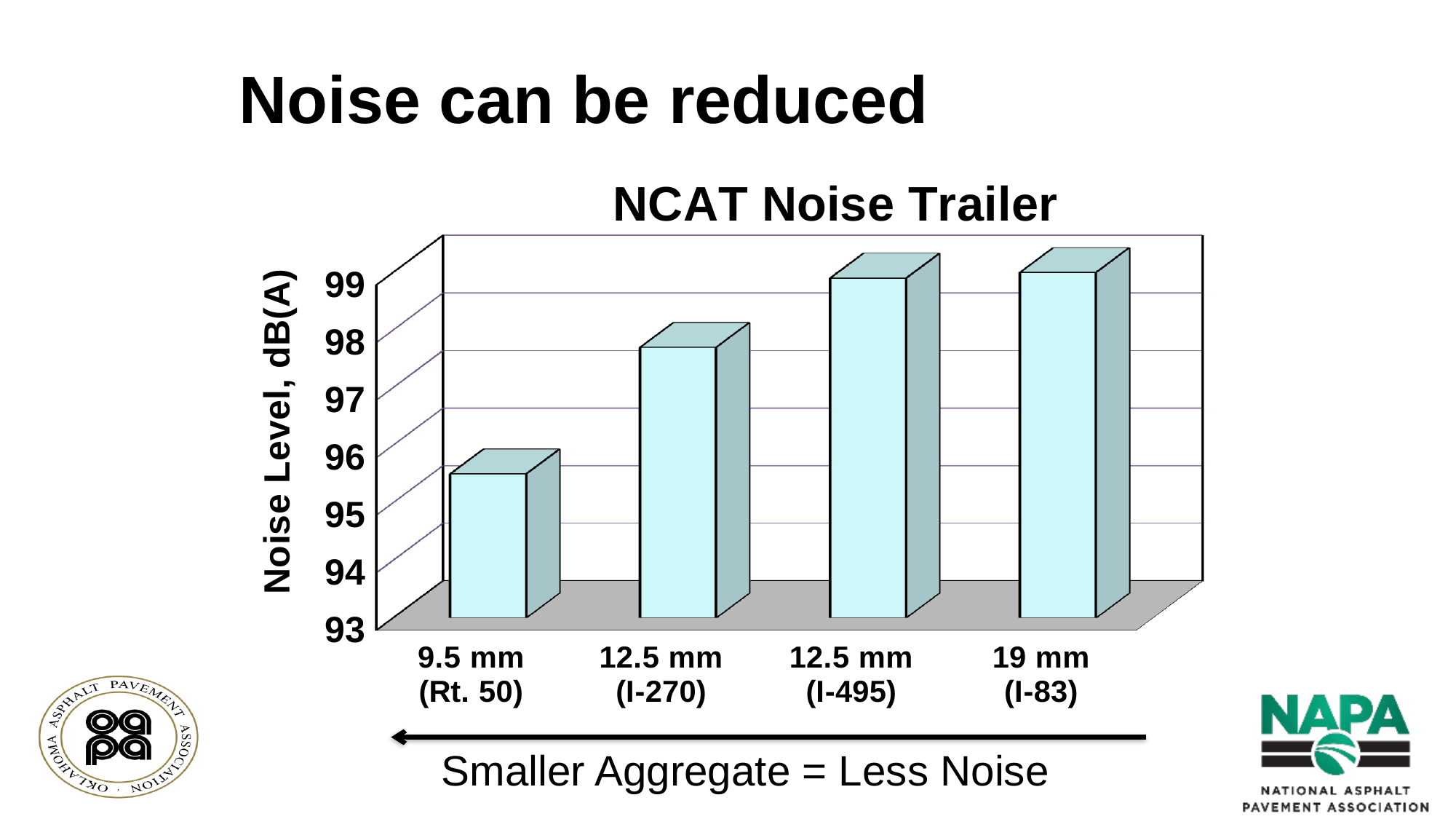
Is the noise level for 19 mm (I-83) greater or less than 98? greater Which category has the lowest noise level? 9.5 mm (Rt. 50) What is the title of the chart? NCAT Noise Trailer Do the noise levels generally rise or fall from left to right across the categories? rise Is the noise level for 9.5 mm (Rt. 50) greater or less than 95? greater Is the noise level for 12.5 mm (I-270) greater or less than 97? greater Which has a higher noise level, 9.5 mm (Rt. 50) or 12.5 mm (I-270)? 12.5 mm (I-270) What type of chart is shown on the slide? Bar chart What is the label of the vertical axis? Noise Level, dB(A) How many bars are plotted in the chart? 4